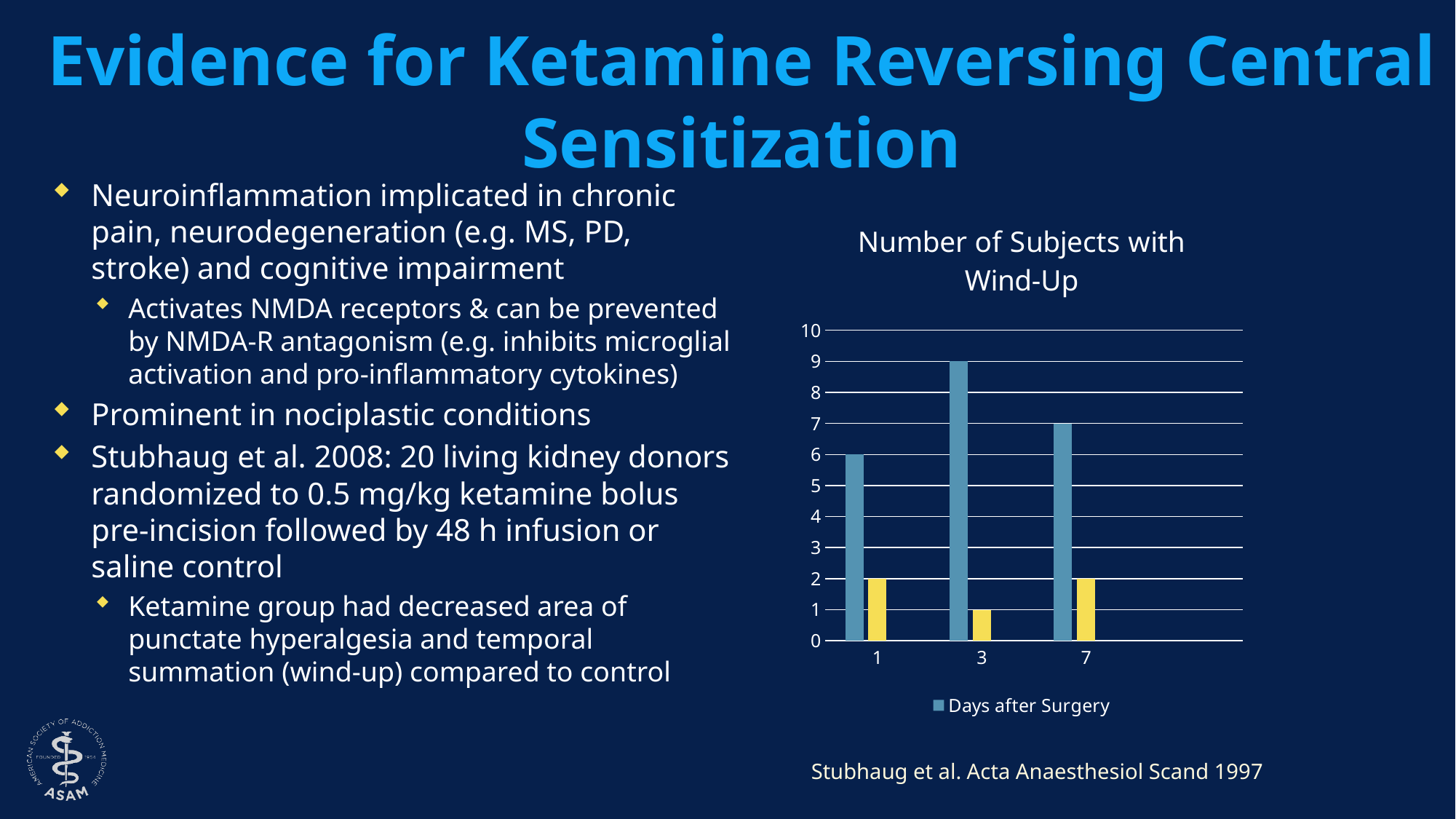
What is the value of the blue bar at day 1 in the "Number of Subjects with Wind-Up" chart? 6 At which day is the blue bar highest in the "Number of Subjects with Wind-Up" chart? 3 How many categories are shown on the x axis of the "Number of Subjects with Wind-Up" chart? 3 What is the value of the yellow bar at day 7 in the "Number of Subjects with Wind-Up" chart? 2 What type of chart is shown under the title "Number of Subjects with Wind-Up"? bar chart Is the value of the blue bar at day 7 in the "Number of Subjects with Wind-Up" chart greater or less than 5? greater At which day is the yellow bar lowest in the "Number of Subjects with Wind-Up" chart? 3 In the "Number of Subjects with Wind-Up" chart, which is larger at day 7: the blue bar or the yellow bar? the blue bar What is the value of the blue bar at day 3 in the "Number of Subjects with Wind-Up" chart? 9 What entry does the legend of the "Number of Subjects with Wind-Up" chart list? Days after Surgery What is the value of the yellow bar at day 3 in the "Number of Subjects with Wind-Up" chart? 1 What is the difference between the blue bar and the yellow bar at day 3 in the "Number of Subjects with Wind-Up" chart? 8